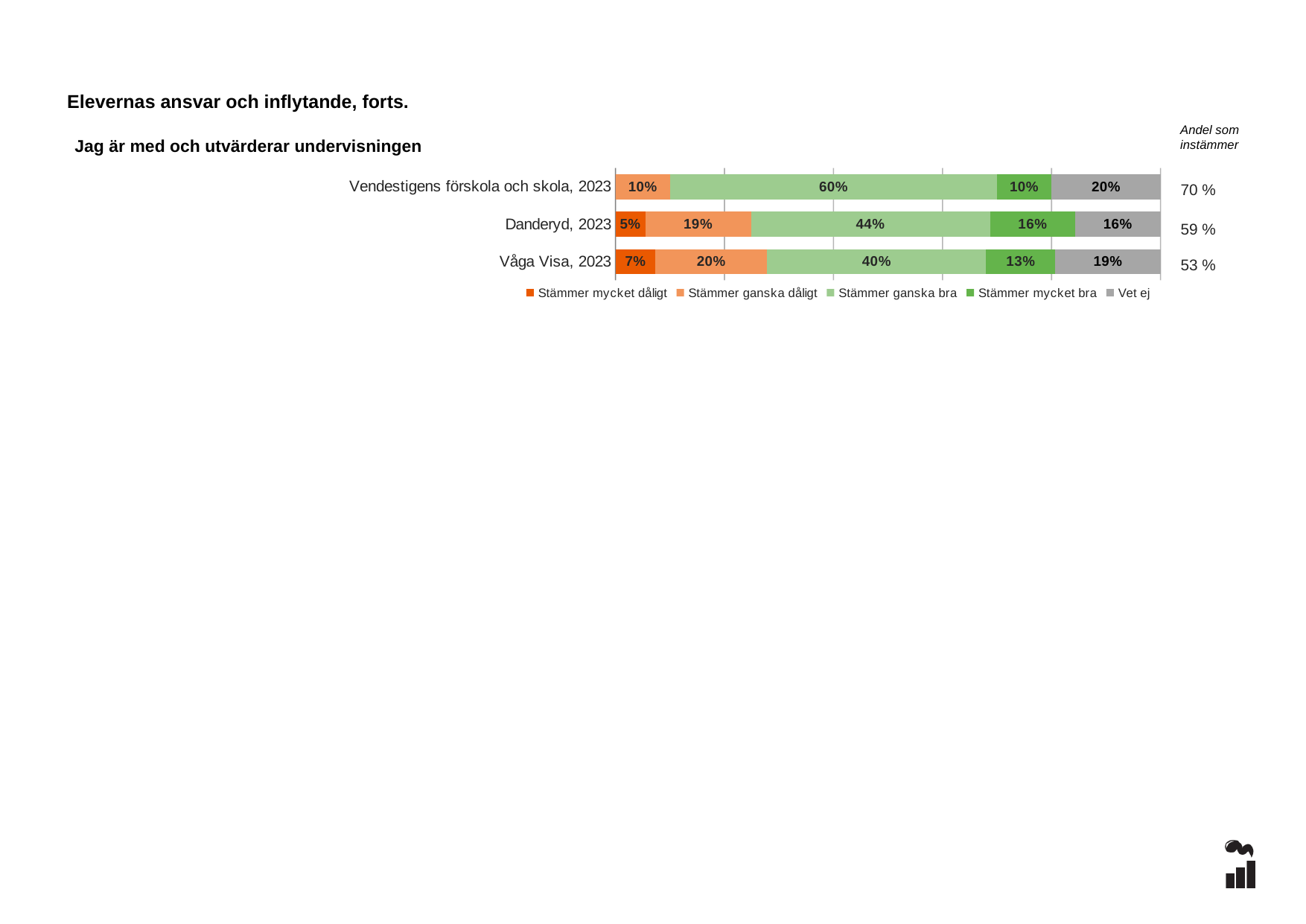
How many series does the legend list? 5 What is the "Andel som instämmer" value shown for Danderyd, 2023? 59 % What is the "Vet ej" share for Danderyd, 2023? 16% What kind of chart is shown on the slide? Stacked bar chart What percentage of respondents at Vendestigens förskola och skola, 2023 answered "Stämmer ganska bra"? 60% Which category has the lowest "Andel som instämmer" value? Våga Visa, 2023 What percentage for Våga Visa, 2023 is "Stämmer mycket dåligt"? 7% Which is larger: the "Stämmer mycket bra" share for Danderyd, 2023 or for Våga Visa, 2023? Danderyd, 2023 What is the difference between the "Stämmer ganska bra" share for Vendestigens förskola och skola, 2023 and Våga Visa, 2023? 20 percentage points What is the question text shown above the chart? Jag är med och utvärderar undervisningen How many categories (bars) are shown in the chart? 3 Which category has the highest "Stämmer ganska bra" share? Vendestigens förskola och skola, 2023